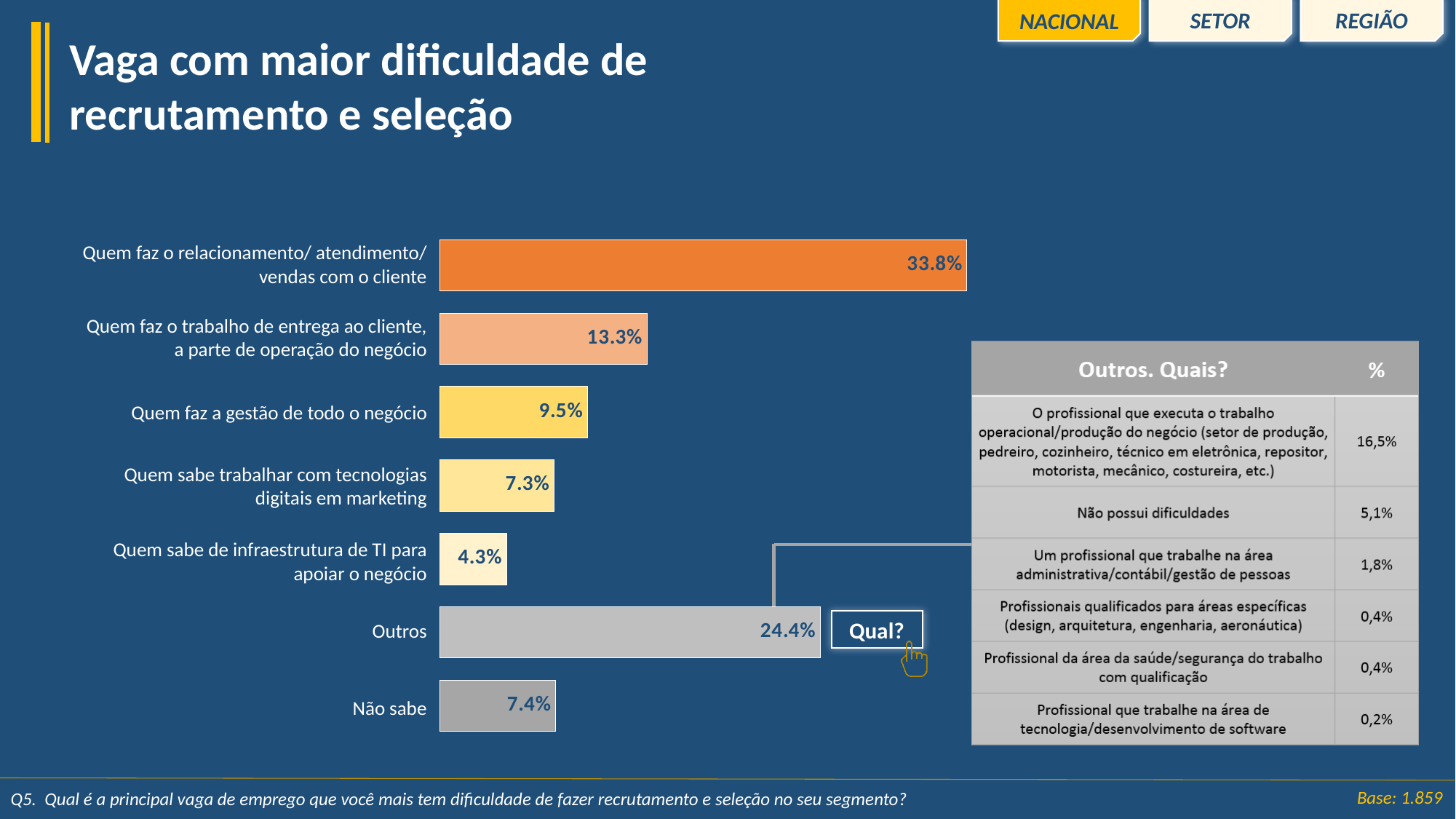
What is the value for 'Quem sabe de infraestrutura de TI para apoiar o negócio'? 4.3% What kind of chart is shown on the slide? Bar chart What is the value for 'Quem faz a gestão de todo o negócio'? 9.5% Which is larger: 'Quem faz o trabalho de entrega ao cliente, a parte de operação do negócio' or 'Quem sabe trabalhar com tecnologias digitais em marketing'? Quem faz o trabalho de entrega ao cliente, a parte de operação do negócio What is the value for 'Outros'? 24.4% What is the difference between 'Quem faz o relacionamento/ atendimento/ vendas com o cliente' and 'Outros'? 9.4 percentage points How many categories are shown in the bar chart? 7 What is the base (number of respondents) shown on the slide? 1.859 What is the difference between 'Quem faz o trabalho de entrega ao cliente, a parte de operação do negócio' and 'Quem faz a gestão de todo o negócio'? 3.8 percentage points Which category has the highest value? Quem faz o relacionamento/ atendimento/ vendas com o cliente Which category has the lowest value? Quem sabe de infraestrutura de TI para apoiar o negócio What is the value for 'Não sabe'? 7.4%